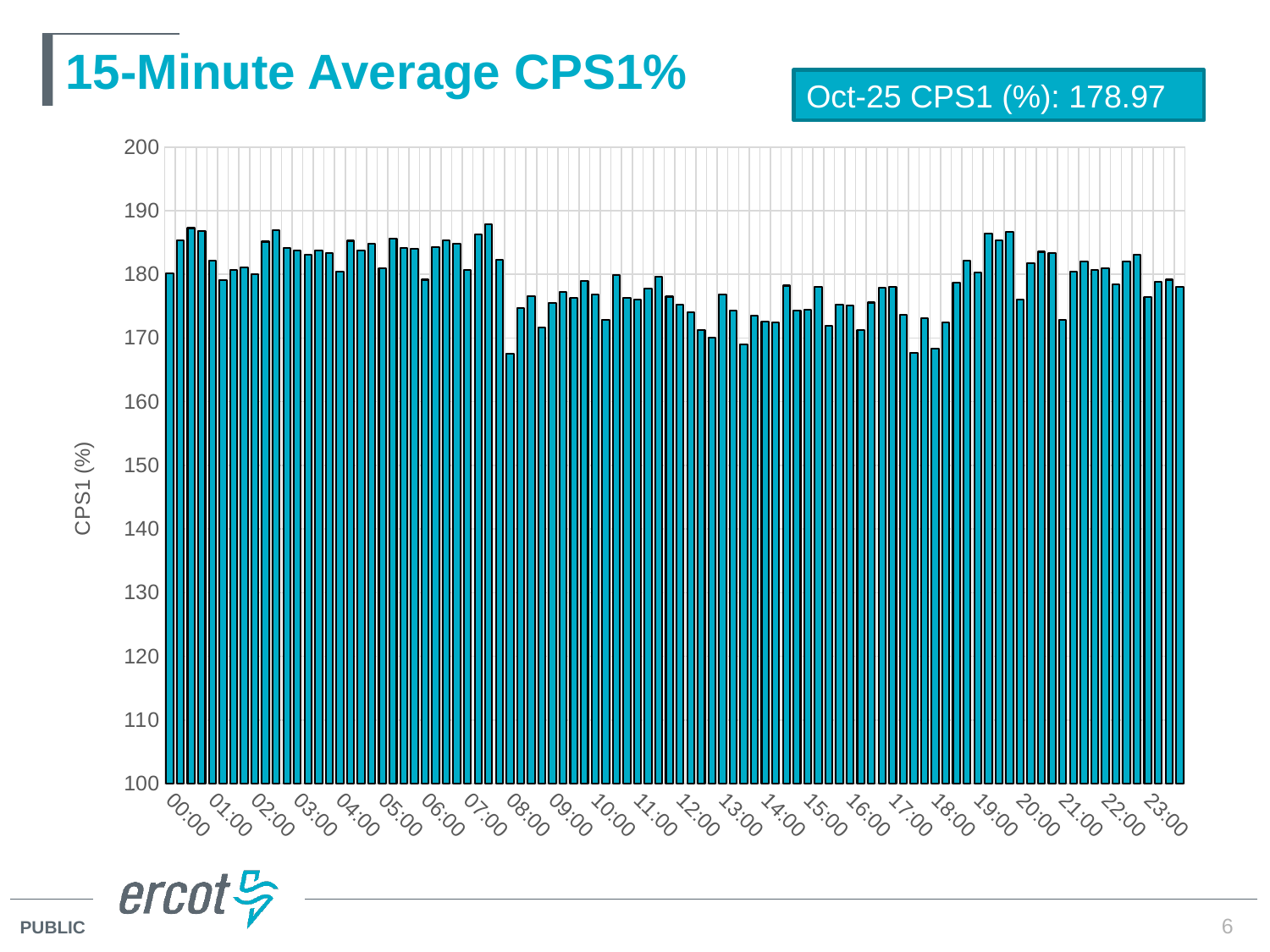
Do the values generally rise or fall between 17:00 and 19:00? rise Is the value for the bar at 08:00 greater or less than 170? less What is the title of the chart on the slide? 15-Minute Average CPS1% Is the value for the bar at 14:00 greater or less than 180? less What kind of chart is shown on the slide? bar chart How many hourly time labels are shown along the x axis of the chart? 24 What is the label on the vertical axis of the chart? CPS1 (%) Which is larger, the value for the bar at 07:00 or the value for the bar at 08:00? 07:00 Is the value for the bar at 12:00 greater or less than 180? less